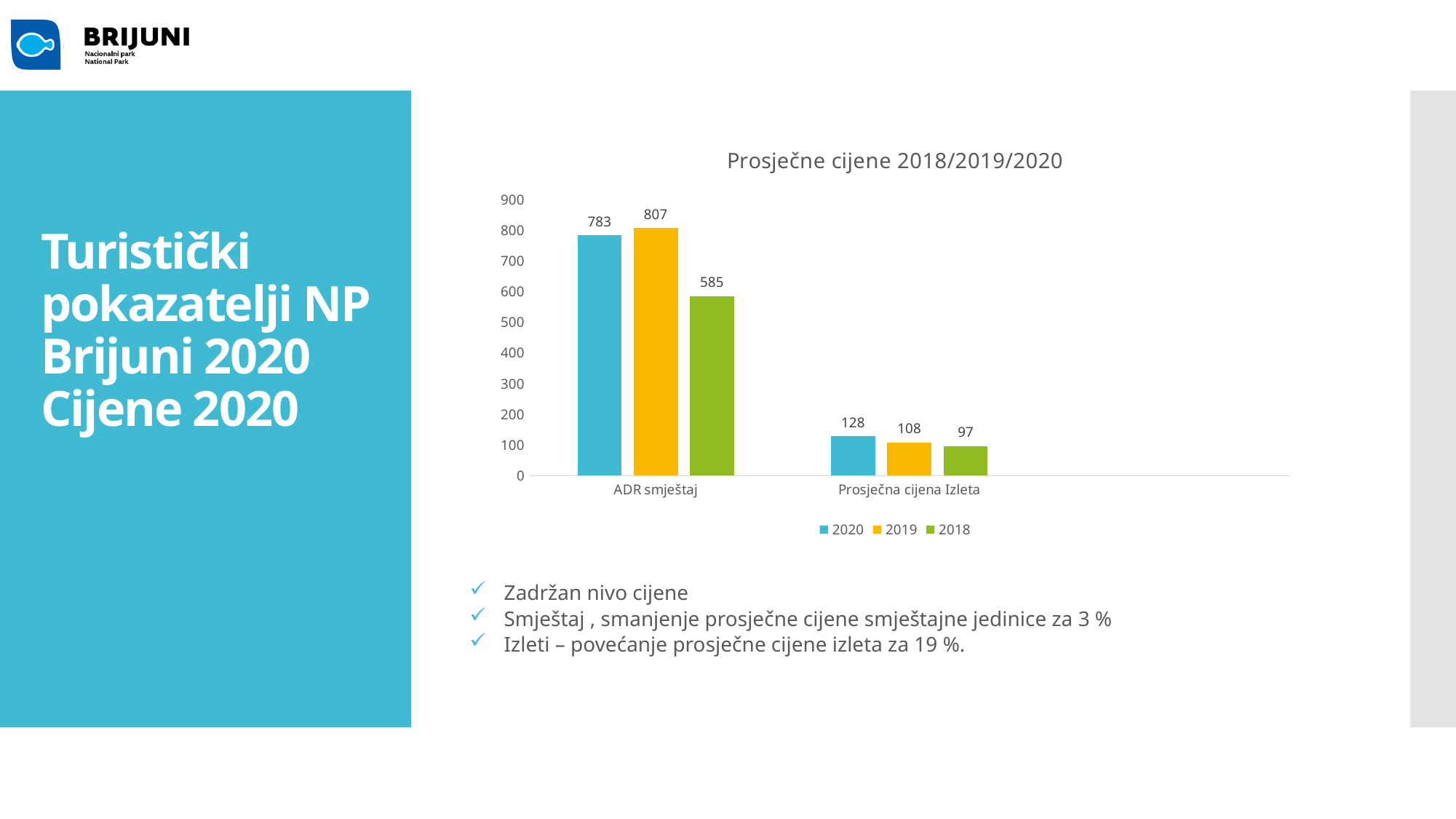
What is the difference between the 2019 and 2020 values for ADR smještaj? 24 How many categories are shown on the x axis? 2 What is the value for 2019 in the ADR smještaj category? 807 What kind of chart is shown on the slide? Bar chart What is the title of the chart? Prosječne cijene 2018/2019/2020 Which year has the highest value in the ADR smještaj category? 2019 What is the value for 2018 in the Prosječna cijena Izleta category? 97 What is the difference between the 2020 and 2018 values for Prosječna cijena Izleta? 31 What is the value for 2020 in the ADR smještaj category? 783 Which is larger for Prosječna cijena Izleta: the 2020 value or the 2019 value? 2020 Which year has the lowest value in the Prosječna cijena Izleta category? 2018 How many series does the legend list? 3